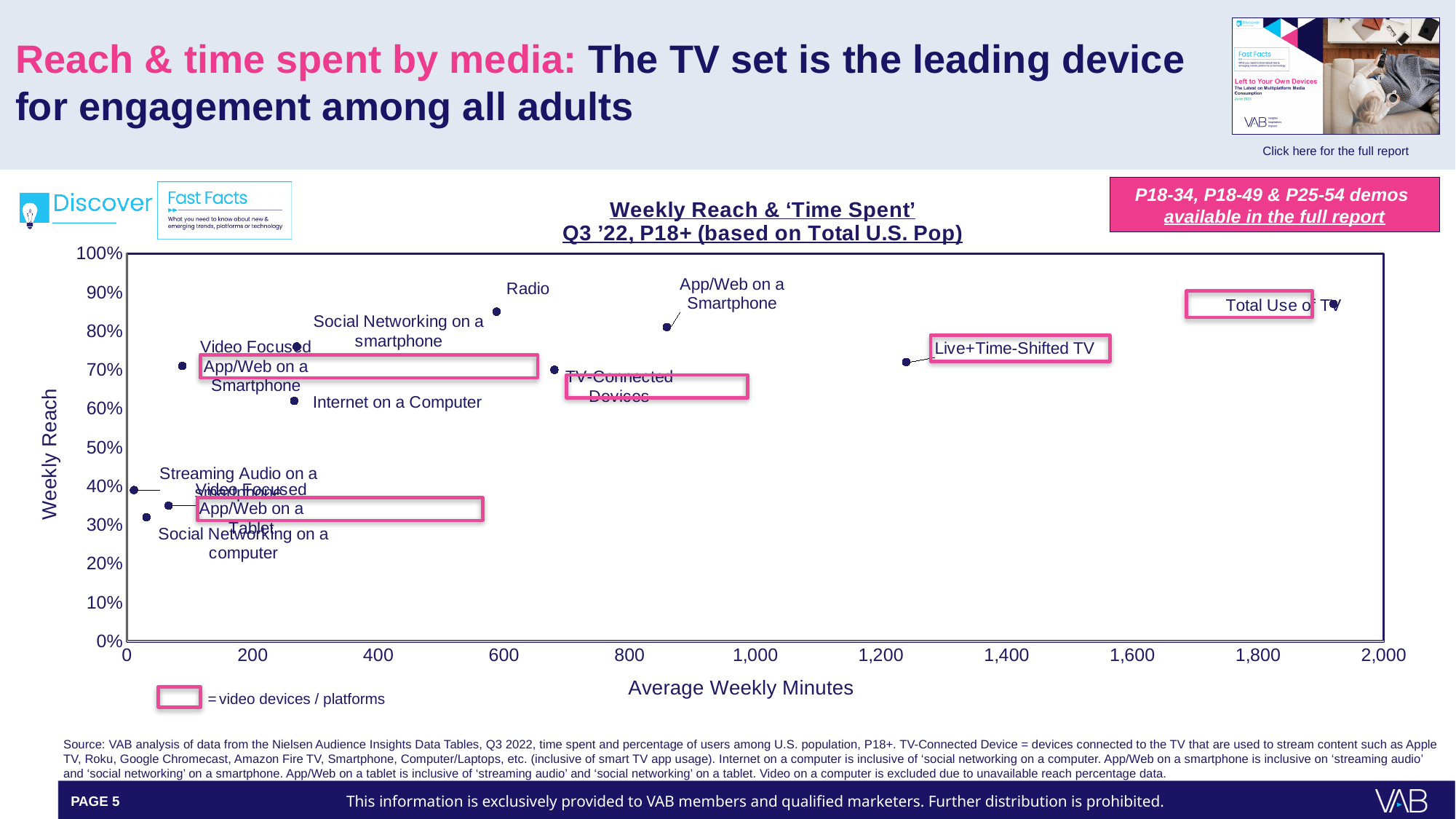
Which media has the lowest Weekly Reach? Social Networking on a computer Which has more Average Weekly Minutes, App/Web on a Smartphone or Live+Time-Shifted TV? Live+Time-Shifted TV Which media has the highest Average Weekly Minutes? Total Use of TV Is the Weekly Reach for Internet on a Computer greater or less than 70%? less Is the Average Weekly Minutes for Radio greater or less than 400? greater What is the title of the chart? Weekly Reach & 'Time Spent' Q3 '22, P18+ (based on Total U.S. Pop) Is the Average Weekly Minutes for Live+Time-Shifted TV greater or less than 1,200? greater Which has a higher Weekly Reach, Radio or TV-Connected Devices? Radio What kind of chart is shown on the slide? scatter chart Which media has the highest Weekly Reach? Total Use of TV What does the x axis of the chart measure? Average Weekly Minutes Which media has the lowest Average Weekly Minutes? Streaming Audio on a smartphone